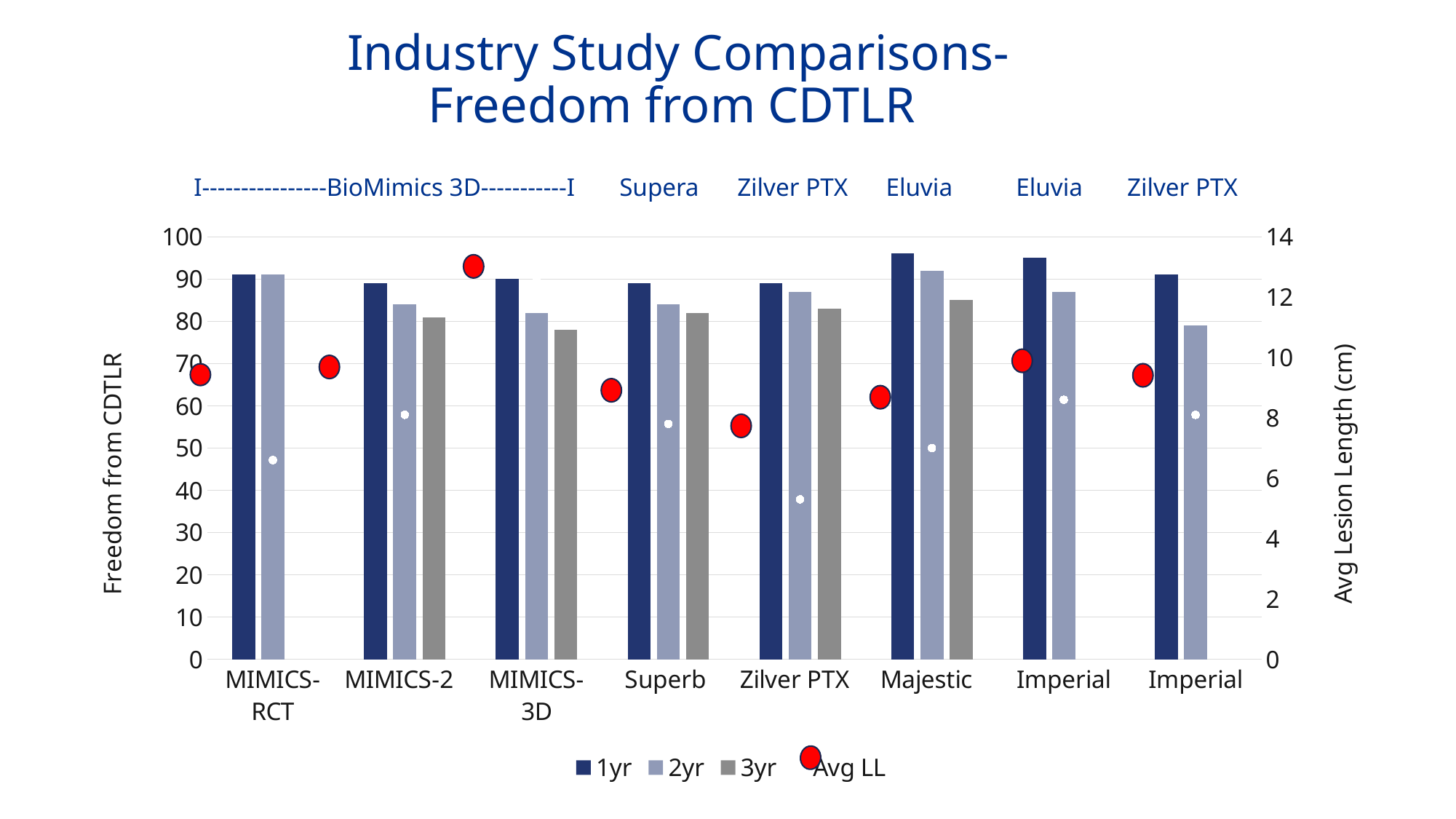
Is the 3yr value for MIMICS-3D greater or less than 80? less Is the 3yr value for Zilver PTX greater or less than 80? greater What is the label of the right-hand vertical axis? Avg Lesion Length (cm) How many categories are shown along the x axis? 8 What kind of chart is shown on the slide? Bar chart with a line/marker series (combination chart) Which category has the highest Avg LL marker? MIMICS-3D Is the 1yr value for Majestic greater or less than 90? greater How many series does the legend list? 4 Which is larger, the 2yr value for Majestic or the 2yr value for Zilver PTX? Majestic Which category has the lowest Avg LL marker? Zilver PTX What is the title of the chart? Industry Study Comparisons- Freedom from CDTLR